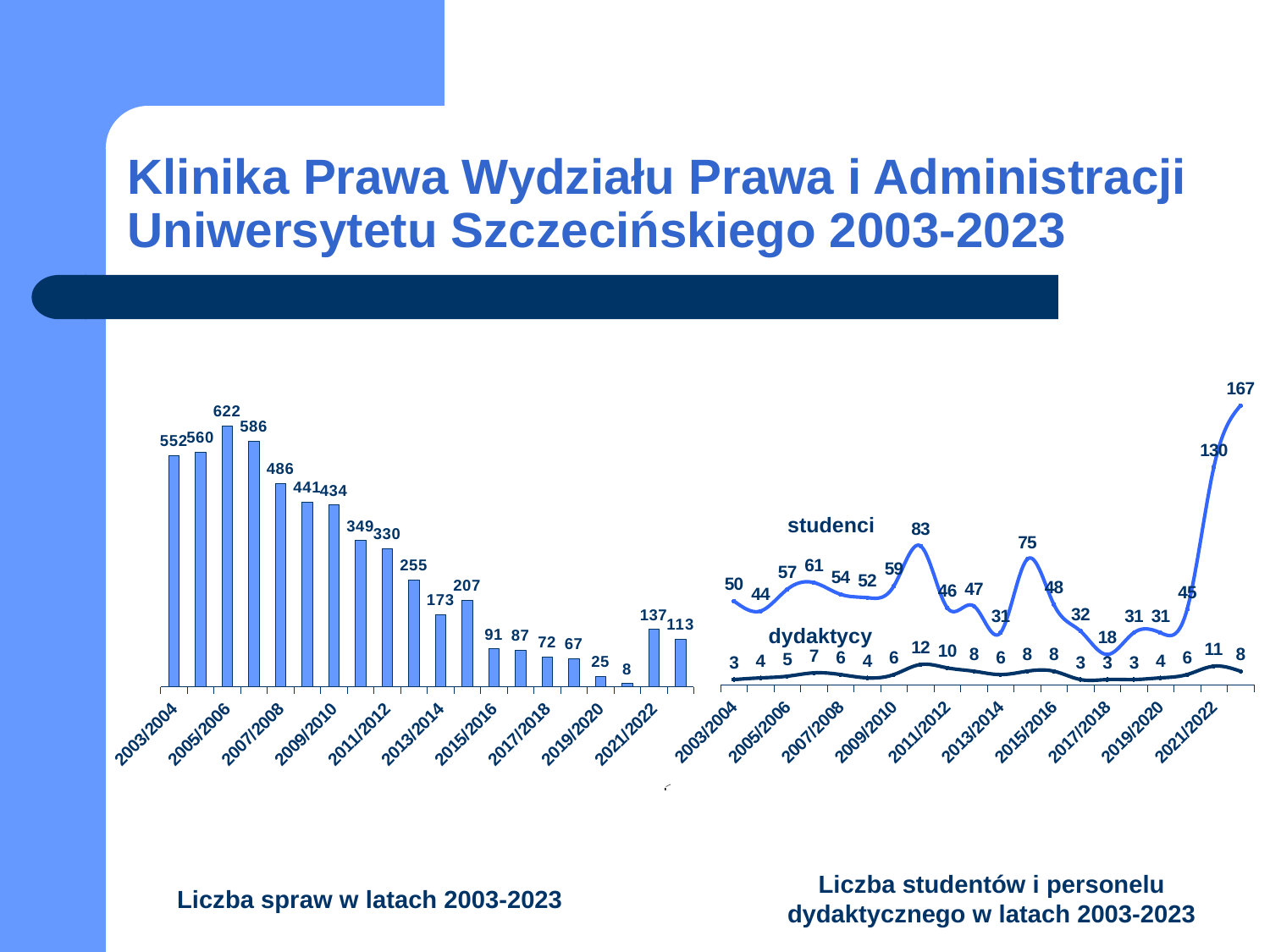
In the chart 'Liczba spraw w latach 2003-2023', what is the lowest value shown? 8 How many bars are plotted in the chart 'Liczba spraw w latach 2003-2023'? 20 In the chart 'Liczba studentów i personelu dydaktycznego w latach 2003-2023', what is the highest value of the studenci series? 167 What kind of chart is 'Liczba spraw w latach 2003-2023'? Bar chart In the chart 'Liczba spraw w latach 2003-2023', which is larger, the value for 2007/2008 or for 2009/2010? 2007/2008 In the chart 'Liczba studentów i personelu dydaktycznego w latach 2003-2023', what is the value for dydaktycy in 2011/2012? 10 In the chart 'Liczba spraw w latach 2003-2023', what is the difference between the values for 2003/2004 and 2021/2022? 415 In the chart 'Liczba studentów i personelu dydaktycznego w latach 2003-2023', what is the value for studenci in 2021/2022? 130 How many series are plotted in the chart 'Liczba studentów i personelu dydaktycznego w latach 2003-2023'? 2 In the chart 'Liczba spraw w latach 2003-2023', what is the value for 2005/2006? 622 In the chart 'Liczba spraw w latach 2003-2023', which year has the highest number of cases? 2005/2006 In the chart 'Liczba spraw w latach 2003-2023', do the values generally rise or fall from 2003/2004 to 2019/2020? Fall